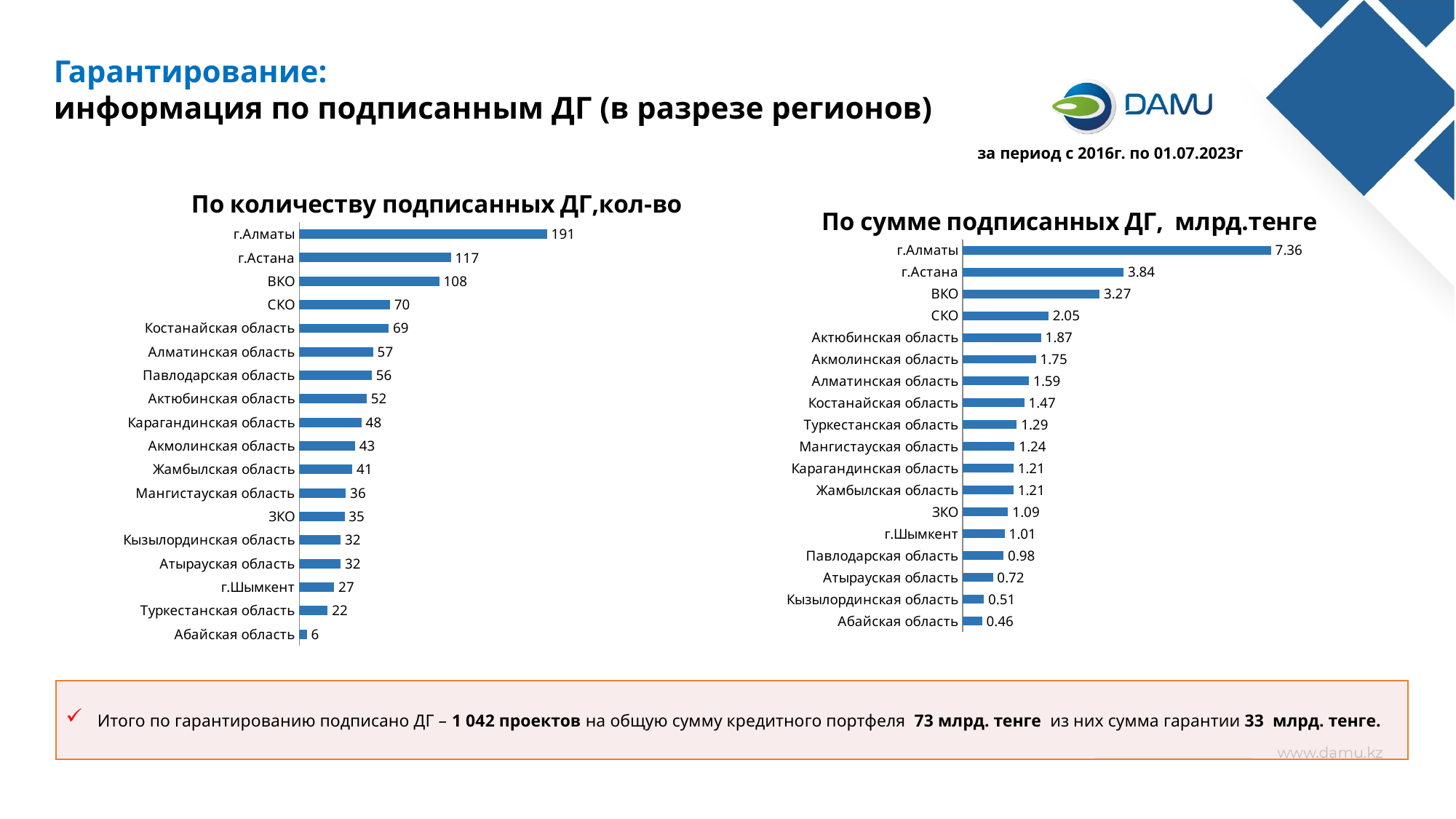
In the chart 'По сумме подписанных ДГ, млрд.тенге', what is the value for г.Шымкент? 1.01 In the chart 'По сумме подписанных ДГ, млрд.тенге', what is the difference between г.Алматы and г.Астана? 3.52 In the chart 'По сумме подписанных ДГ, млрд.тенге', which is larger: Актюбинская область or Акмолинская область? Актюбинская область In the chart 'По количеству подписанных ДГ,кол-во', which region has the highest value? г.Алматы In the chart 'По количеству подписанных ДГ,кол-во', which region has the lowest value? Абайская область In the chart 'По количеству подписанных ДГ,кол-во', what is the value for г.Астана? 117 What type of chart is 'По количеству подписанных ДГ,кол-во'? Bar chart In the chart 'По сумме подписанных ДГ, млрд.тенге', which region has the lowest value? Абайская область In the chart 'По сумме подписанных ДГ, млрд.тенге', what is the value for СКО? 2.05 In the chart 'По количеству подписанных ДГ,кол-во', how many regions are shown? 18 In the chart 'По количеству подписанных ДГ,кол-во', what is the difference between г.Алматы and ВКО? 83 What period does the slide state the data covers? с 2016г. по 01.07.2023г